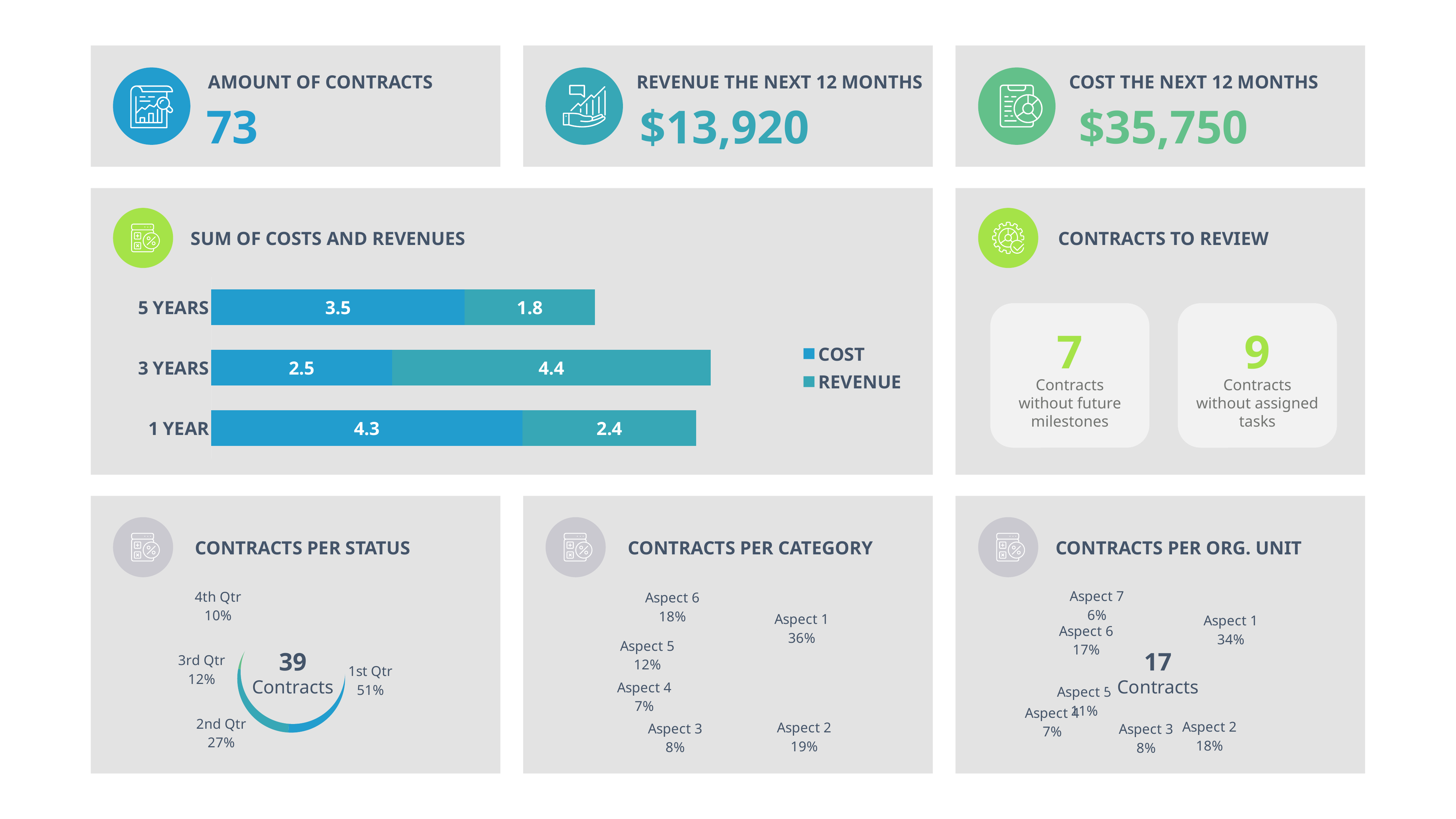
In the Contracts per Status chart, what share does 1st Qtr have? 51% In the Sum of Costs and Revenues chart, what is the revenue value for 3 years? 4.4 In the Contracts per Category chart, what is the percentage for Aspect 1? 36% In the Contracts per Org. Unit chart, which aspect has the smallest share? Aspect 7 In the Sum of Costs and Revenues chart, for 5 years, which is larger: cost or revenue? Cost In the Sum of Costs and Revenues chart, what is the cost value for 5 years? 3.5 How many series does the legend of the Sum of Costs and Revenues chart list? 2 In the Sum of Costs and Revenues chart, what is the difference between the cost for 1 year and the cost for 3 years? 1.8 What kind of chart is the Sum of Costs and Revenues chart? Stacked bar chart In the Sum of Costs and Revenues chart, which period has the lowest combined total? 5 years In the Contracts per Status chart, which quarter has the largest share? 1st Qtr In the Sum of Costs and Revenues chart, what is the total of the 1 year bar? 6.7